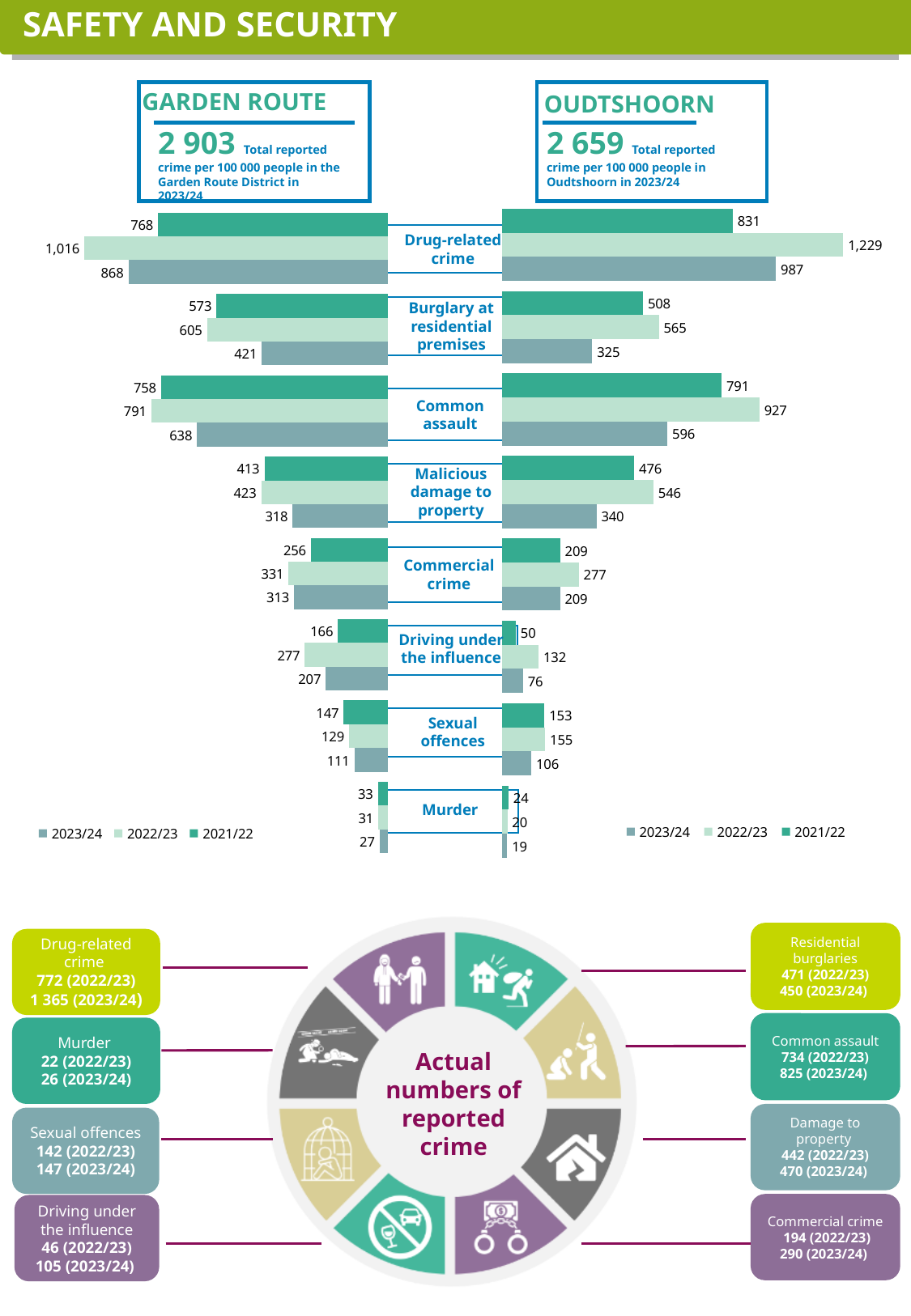
In the Garden Route chart, what is the value for Drug-related crime in 2022/23? 1,016 In the Oudtshoorn chart, what is the value for Common assault in 2022/23? 927 How many crime categories are shown in the Garden Route chart? 8 What type of chart is used to show the Garden Route crime figures? Bar chart In the Oudtshoorn chart, which crime category has the highest value in 2022/23? Drug-related crime Which is larger: the 2023/24 value for Common assault in the Garden Route chart or in the Oudtshoorn chart? Garden Route In the Oudtshoorn chart, what is the difference between the 2022/23 and 2021/22 values for Drug-related crime? 398 In the Oudtshoorn chart, what is the value for Driving under the influence in 2021/22? 50 In the Garden Route chart, what is the difference between the 2022/23 and 2023/24 values for Burglary at residential premises? 184 In the Garden Route chart, which crime category has the lowest value in 2023/24? Murder What is the total reported crime per 100 000 people shown for Oudtshoorn in 2023/24? 2 659 How many series does the legend of the Oudtshoorn chart list? 3